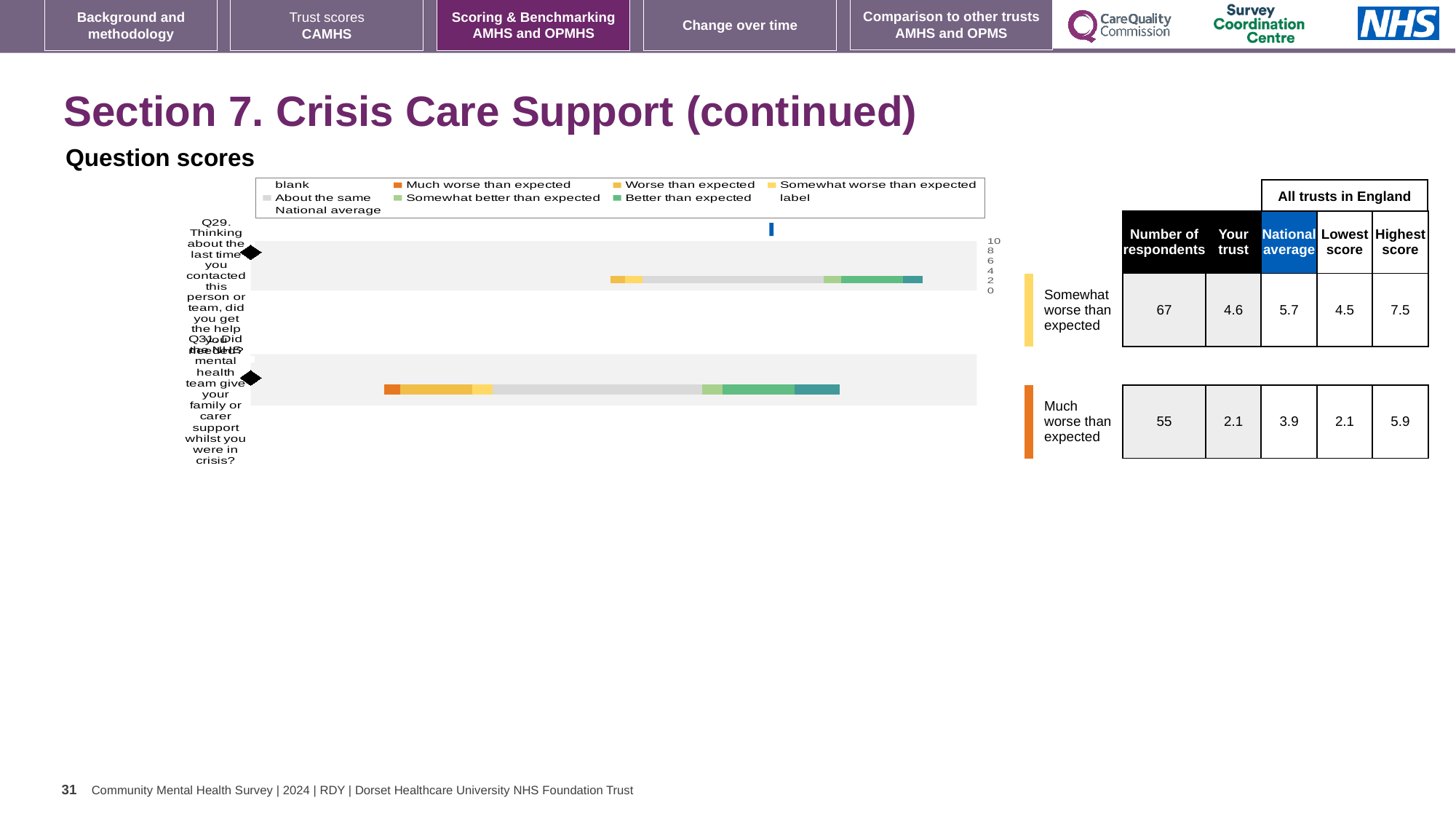
According to the table beside the chart, what is the number of respondents for Q31? 55 According to the table beside the chart, what is the national average for Q29? 5.7 According to the table beside the chart, what is the 'Your trust' score for Q29? 4.6 What is the difference between the highest score and the lowest score for Q29 in the table? 3.0 What is the highest tick value shown on the chart's axis? 10 What is the difference between the national average and the 'Your trust' score for Q31? 1.8 How many questions (categories) are plotted in the chart? 2 Which question has the higher 'Your trust' score, Q29 or Q31? Q29 What kind of chart is shown under 'Question scores'? bar chart According to the table beside the chart, what is the 'Your trust' score for Q31? 2.1 Which legend entry is shown in orange? Much worse than expected How many entries does the chart legend list? 9